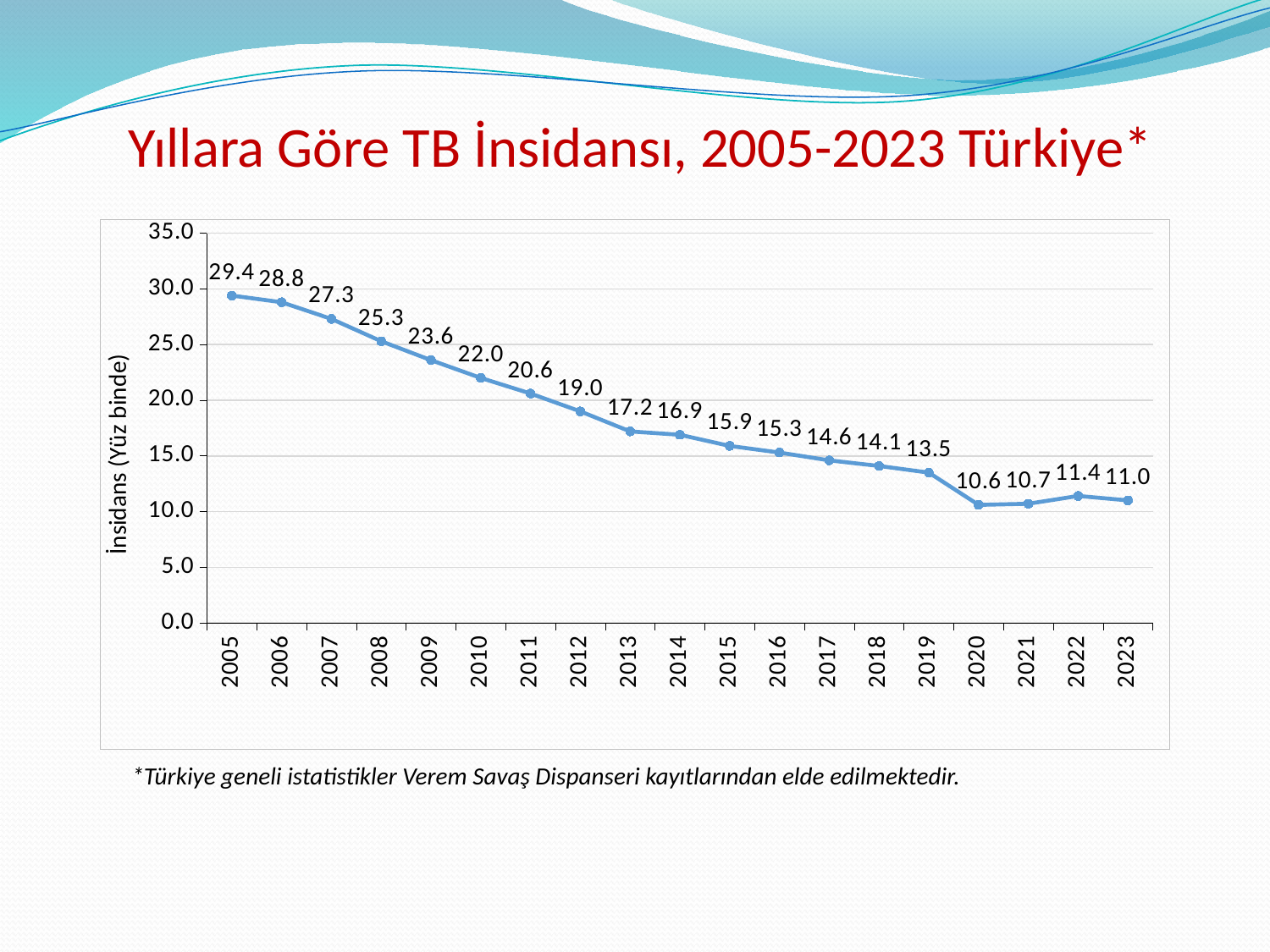
What is the overall trend of TB incidence from 2005 to 2023? falling What is the difference between the TB incidence in 2019 and in 2020? 2.9 What is the TB incidence value for 2023? 11.0 Which year has the lowest TB incidence? 2020 What is the TB incidence value for 2013? 17.2 Is the TB incidence value for 2012 greater or less than 20.0? less How many years are plotted on the chart? 19 What kind of chart is shown on the slide? line chart What is the difference between the TB incidence in 2005 and in 2023? 18.4 What is the TB incidence value for 2005? 29.4 Which year has the highest TB incidence? 2005 Which year has a higher TB incidence, 2010 or 2016? 2010